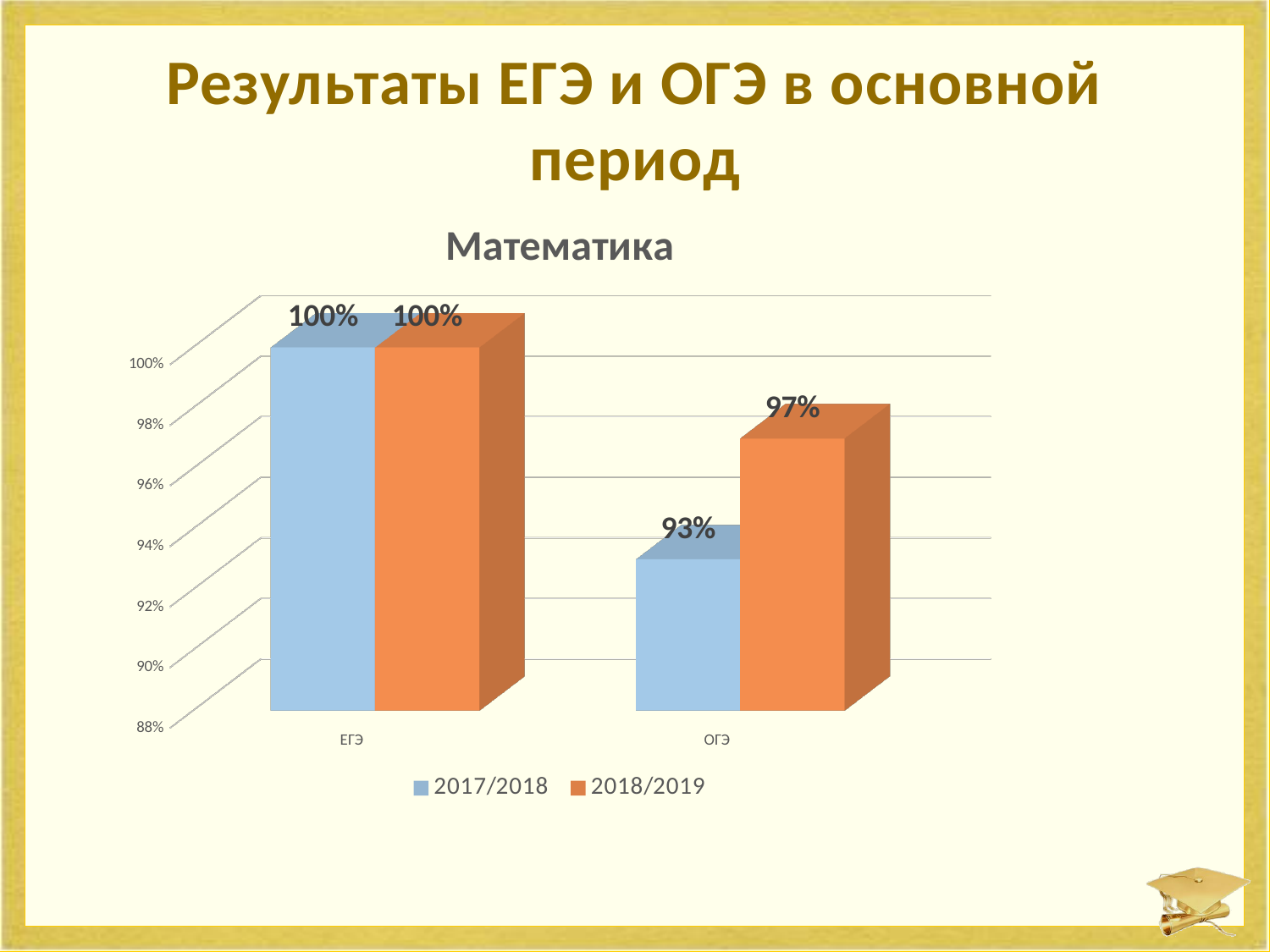
What is the value for ЕГЭ in the 2018/2019 series? 100% For ОГЭ, which series has the larger value, 2017/2018 or 2018/2019? 2018/2019 Which category has the lowest value in the 2017/2018 series? ОГЭ What is the value for ОГЭ in the 2018/2019 series? 97% What is the difference between the 2018/2019 and 2017/2018 values for ОГЭ? 4% What is the title of the chart? Математика What kind of chart is shown on the slide? Bar chart How many series does the legend list? 2 Which colour represents the 2018/2019 series? Orange How many categories are shown on the x axis? 2 What is the value for ЕГЭ in the 2017/2018 series? 100% What is the value for ОГЭ in the 2017/2018 series? 93%